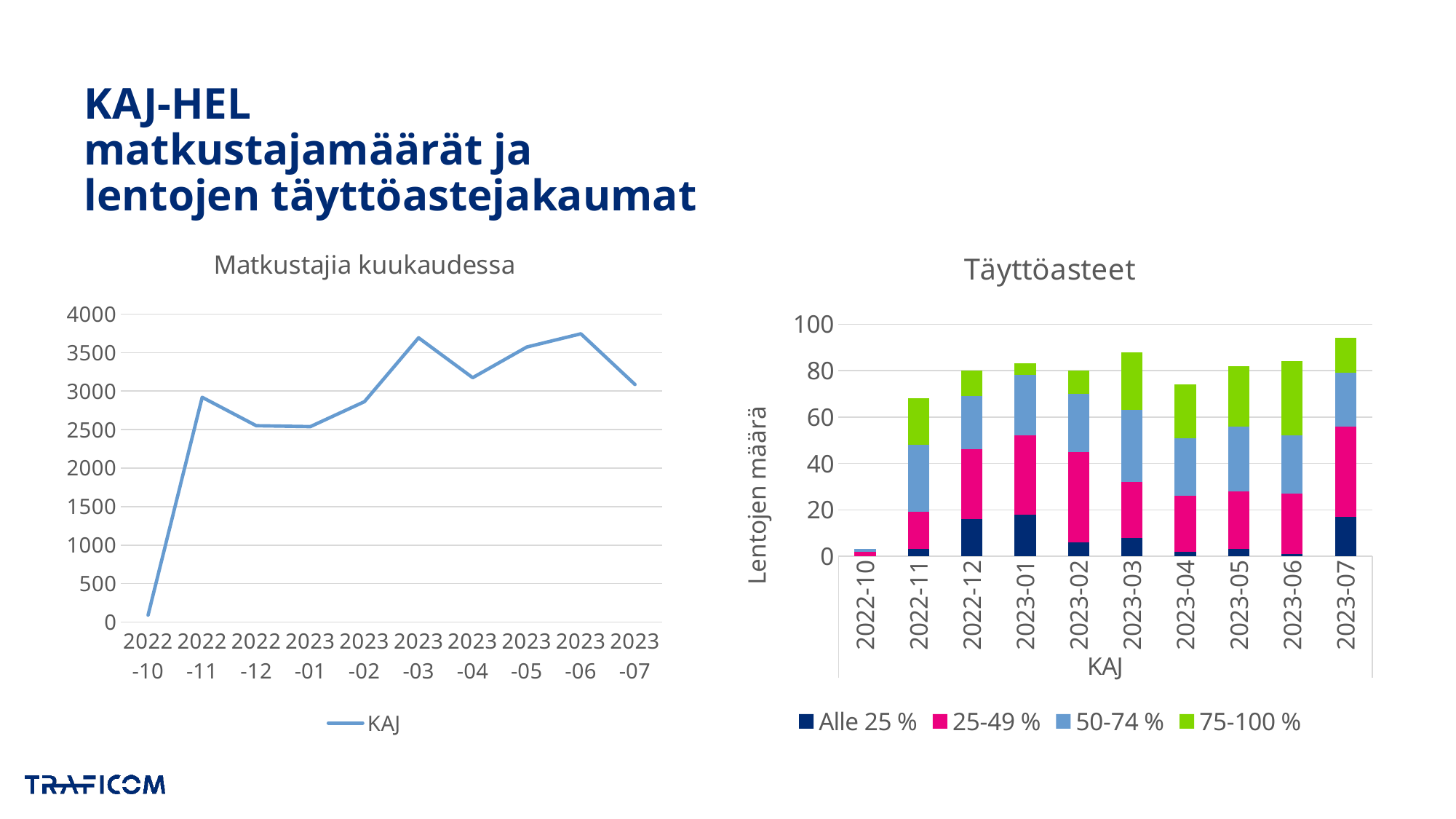
In the 'Matkustajia kuukaudessa' chart, is the value for 2023-03 greater or less than 3500? greater In the 'Täyttöasteet' chart, what is the y-axis title? Lentojen määrä In the 'Matkustajia kuukaudessa' chart, does the value rise or fall from 2022-10 to 2022-11? rise In the 'Täyttöasteet' chart, which month has the tallest stacked bar? 2023-07 In the 'Matkustajia kuukaudessa' chart, which is larger, the value for 2022-11 or 2022-12? 2022-11 In the 'Matkustajia kuukaudessa' chart, how many months are plotted? 10 In the 'Matkustajia kuukaudessa' chart, which month has the lowest value? 2022-10 In the 'Täyttöasteet' chart, is the total for 2023-04 greater or less than 80? less In the 'Täyttöasteet' chart, how many series does the legend list? 4 What kind of chart is the 'Täyttöasteet' chart? bar chart What kind of chart is the 'Matkustajia kuukaudessa' chart? line chart In the 'Matkustajia kuukaudessa' chart, is the value for 2022-11 greater or less than 2500? greater